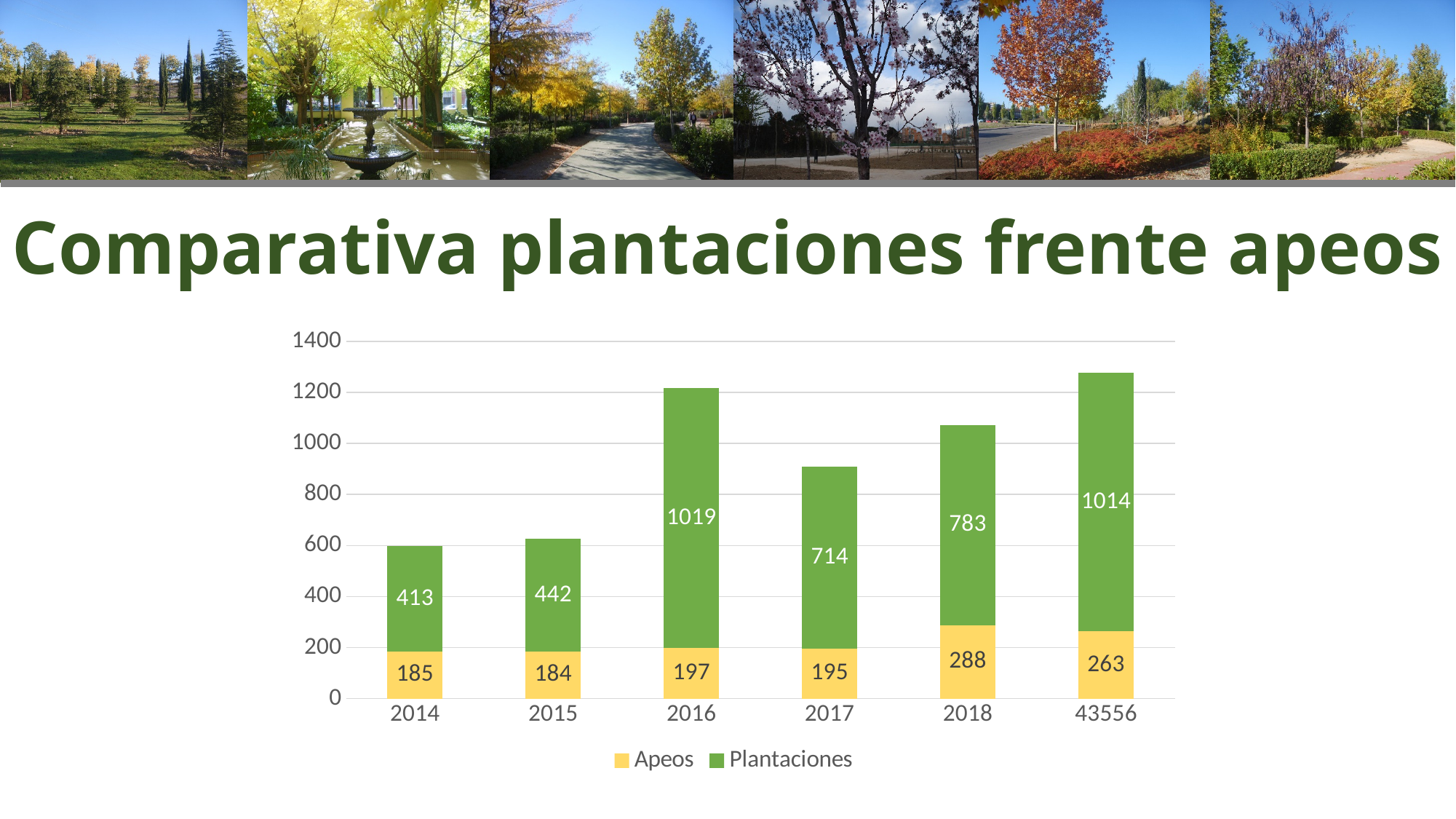
What kind of chart is shown on the slide? Stacked bar chart What is the Apeos value for 2018? 288 How many categories are shown on the x axis? 6 Which category has the highest Plantaciones value? 2016 What is the total of the stacked bar for 2017? 909 How many series does the legend list? 2 Which category has the lowest Apeos value? 2015 What is the Apeos value for 2014? 185 What is the difference between the Plantaciones values for 2018 and 2017? 69 What is the Plantaciones value for the category labelled 43556? 1014 Which is larger, the Apeos value for 2018 or the Apeos value for 43556? 2018 What is the Plantaciones value for 2016? 1019